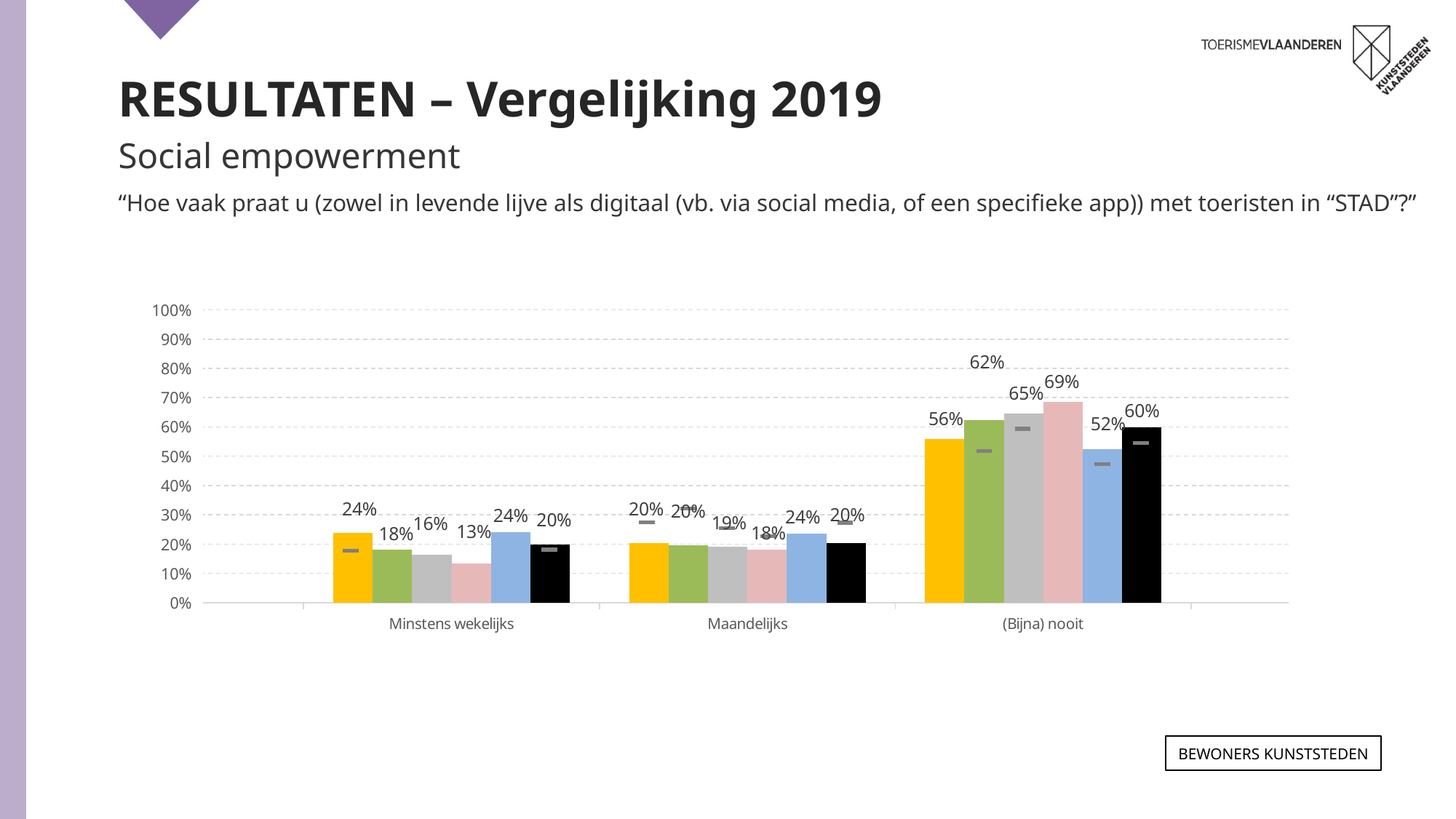
How many bars are plotted for each category in the chart? 6 Which category has the highest values overall in the chart? (Bijna) nooit What is the value of the pink bar for "(Bijna) nooit"? 69% Within "(Bijna) nooit", which coloured bar is the lowest? blue (52%) What is the difference between the pink bar (69%) and the blue bar (52%) for "(Bijna) nooit"? 17% What is the value of the yellow bar for "(Bijna) nooit"? 56% Is the value of the green bar for "(Bijna) nooit" greater or less than 60%? greater Which is larger for "Minstens wekelijks": the yellow bar or the grey bar? the yellow bar (24%) What is the value of the pink bar for "Minstens wekelijks"? 13% What kind of chart is shown on the slide? bar chart How many categories are shown on the x axis of the chart? 3 What is the value of the blue bar for "Maandelijks"? 24%